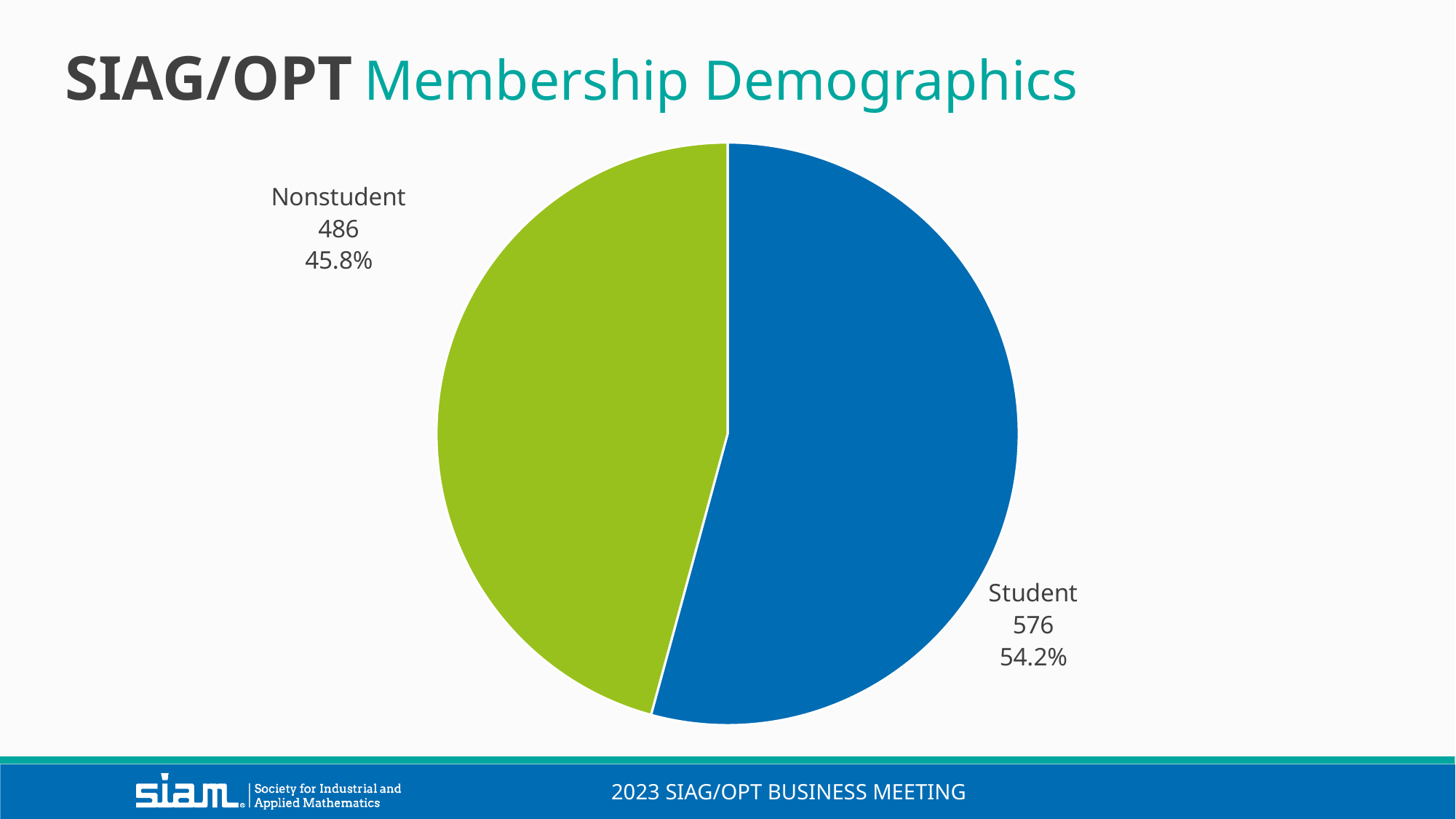
Which category has the smaller slice of the pie? Nonstudent Is the Student count larger or smaller than the Nonstudent count? larger Which category has the larger slice of the pie? Student What is the difference between the Student and Nonstudent member counts? 90 How many members are in the Nonstudent category? 486 What kind of chart is shown on the slide? pie chart How many members are in the Student category? 576 What share of the pie does the Nonstudent slice represent? 45.8% What share of the pie does the Student slice represent? 54.2% What colour is the Nonstudent slice? green How many categories are shown in the pie chart? 2 What is the total number of members across both slices? 1062